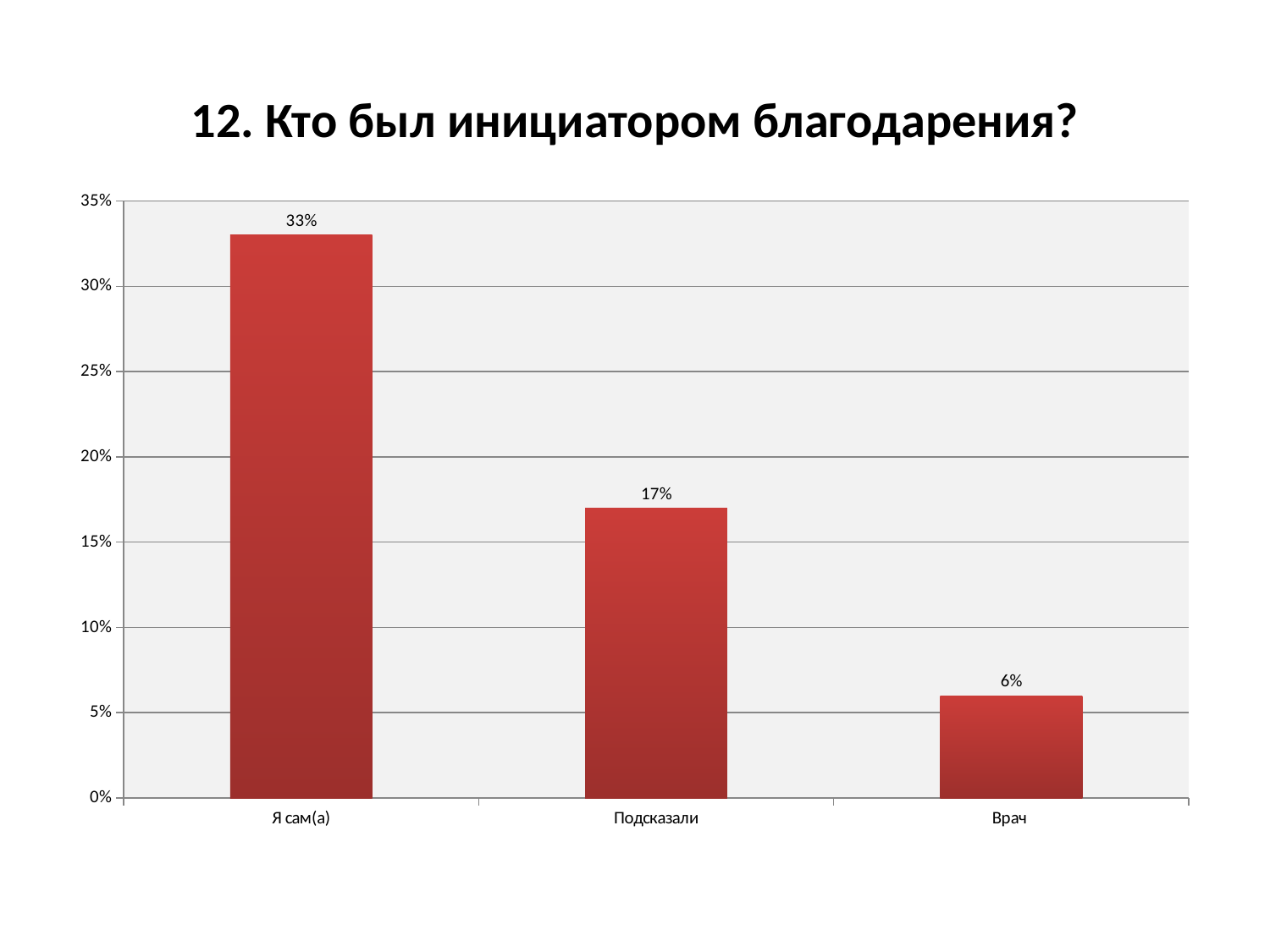
Which category has the highest value? Я сам(а) Which category has the lowest value? Врач Is the value for Я сам(а) greater or less than 30%? greater What is the value for Подсказали? 17% What kind of chart is shown on the slide? bar chart What is the value for Я сам(а)? 33% Which is larger, the value for Подсказали or the value for Врач? Подсказали What is the difference between the values for Я сам(а) and Подсказали? 16% What is the difference between the values for Подсказали and Врач? 11% What is the value for Врач? 6% How many categories are shown on the x axis? 3 What is the title of the chart? 12. Кто был инициатором благодарения?